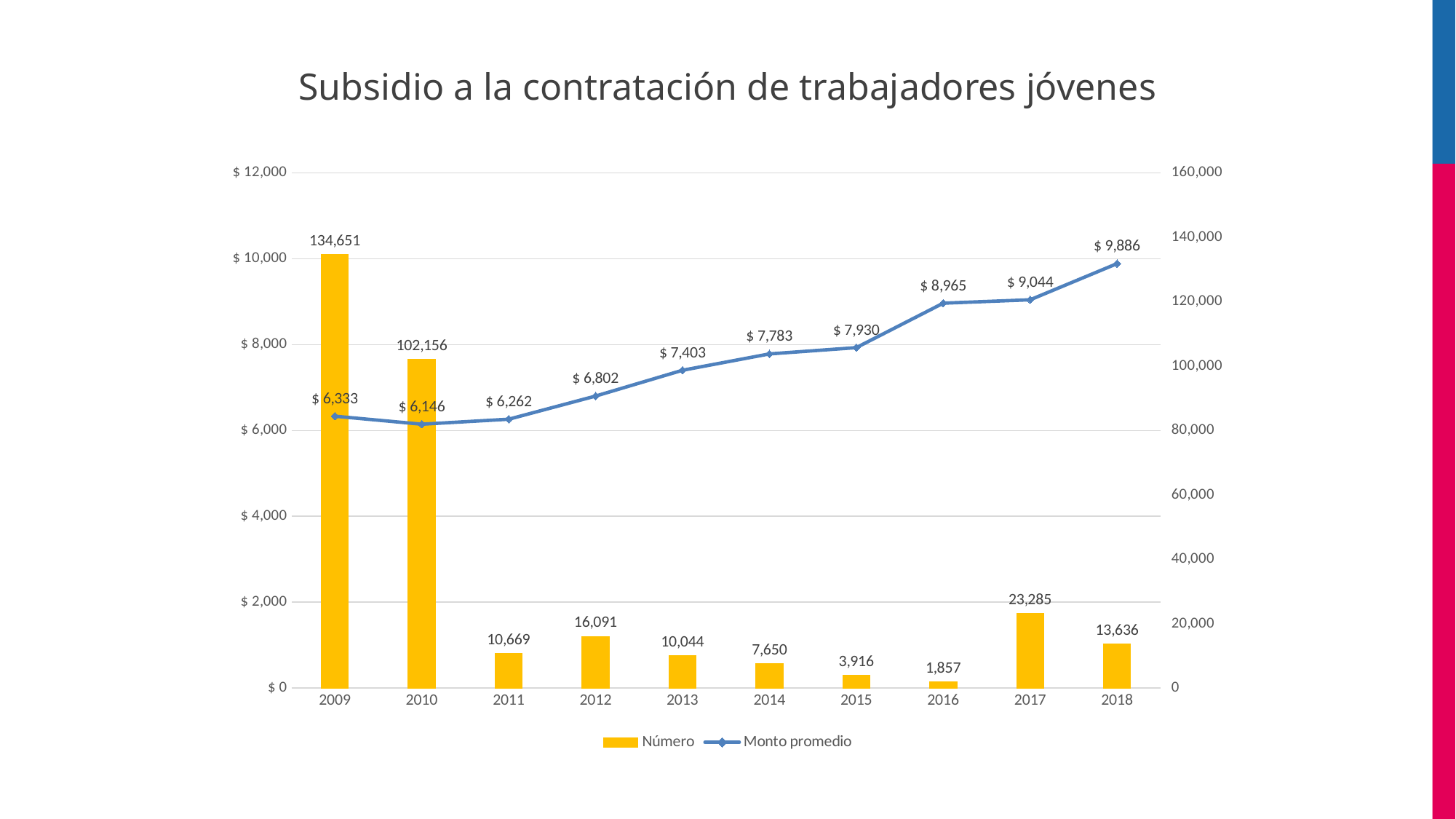
Is the Número for 2012 greater or less than 20,000? less What is the value of Número for 2016? 1,857 What is the Monto promedio for 2018? $ 9,886 Which is larger, the Monto promedio for 2009 or for 2011? 2009 How many years are shown on the x axis? 10 Which year has the highest Monto promedio? 2018 What is the difference in Número between 2017 and 2018? 9,649 What is the value of Número for 2009? 134,651 What kind of chart is this? Combined bar and line chart Does the Monto promedio rise or fall from 2011 to 2018? rise Which year has the lowest Número? 2016 How many series does the legend list? 2